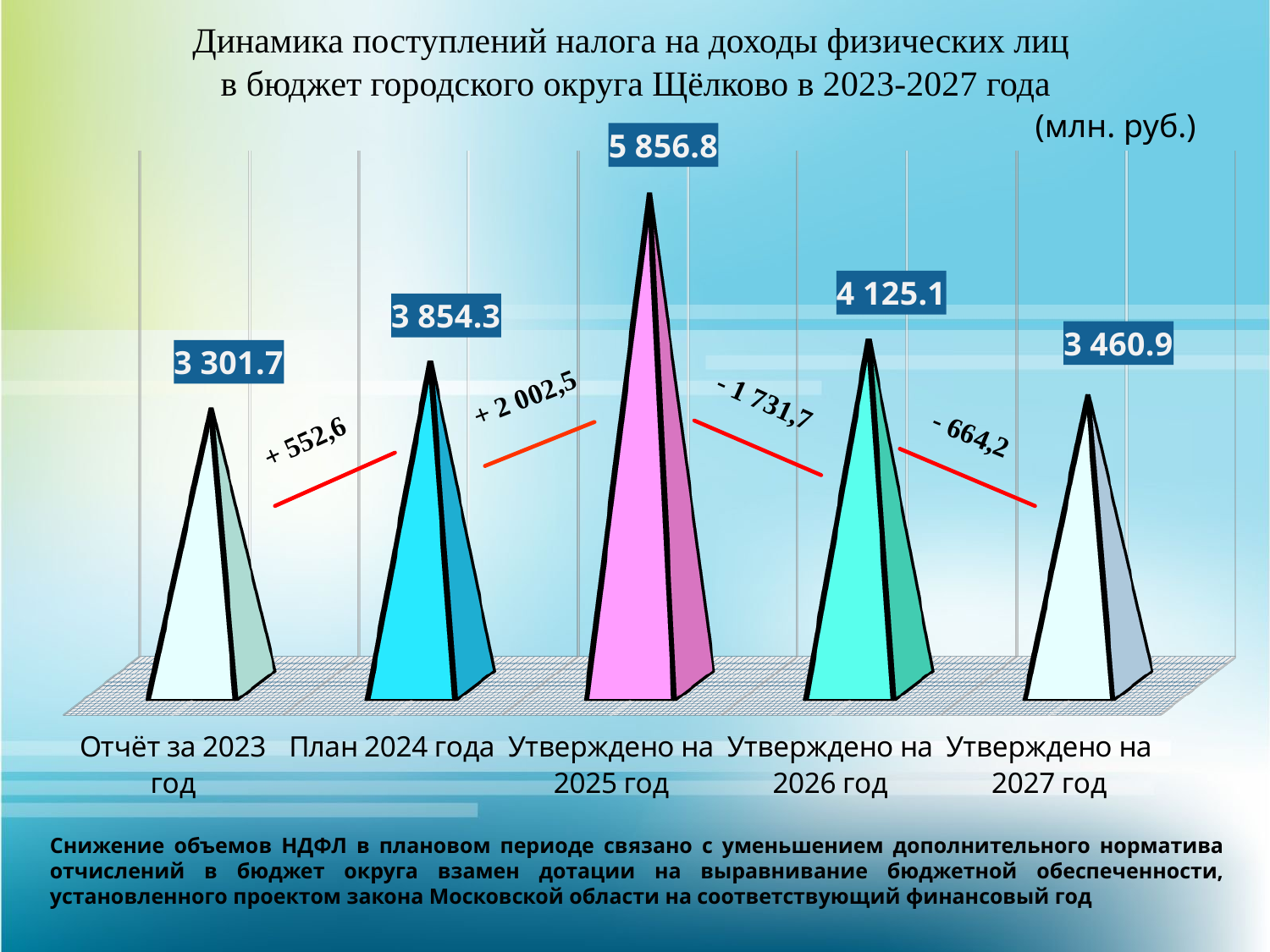
What is the value for "Утверждено на 2027 год"? 3 460.9 Which category has the highest value? Утверждено на 2025 год Which category has the lowest value? Отчёт за 2023 год What kind of chart is shown on the slide? Bar chart What is the value for "Утверждено на 2025 год"? 5 856.8 In what units are the values on the chart given? млн. руб. Which is larger, the value for "План 2024 года" or the value for "Утверждено на 2027 год"? План 2024 года What is the value for "Отчёт за 2023 год"? 3 301.7 What is the difference between the values for "Утверждено на 2025 год" and "Утверждено на 2026 год"? 1 731,7 How many categories are shown on the chart? 5 What is the value for "План 2024 года"? 3 854.3 What is the difference between the values for "План 2024 года" and "Отчёт за 2023 год"? 552,6